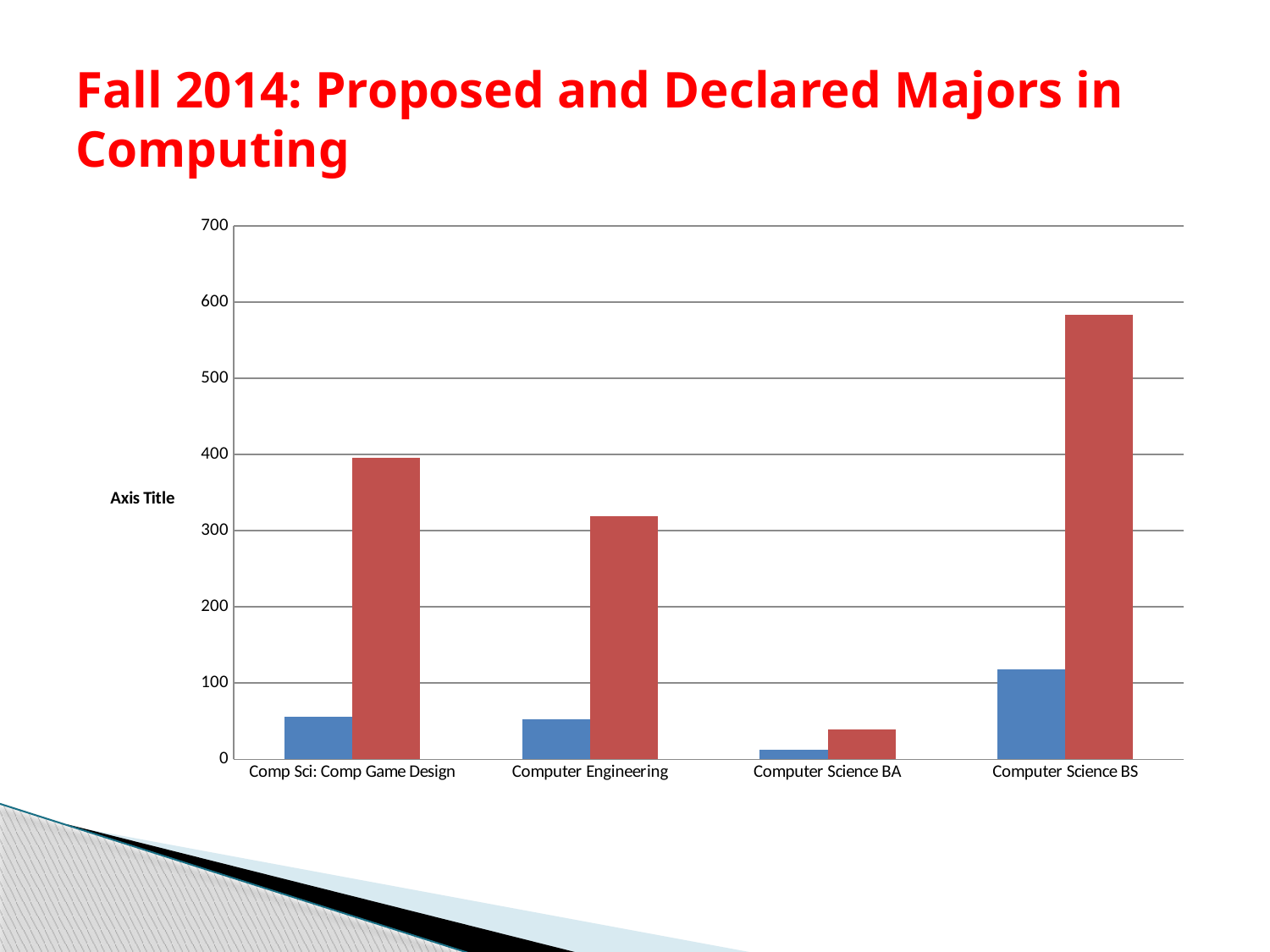
Which category has the shortest blue bar? Computer Science BA Which category has the shortest red bar? Computer Science BA Which category has the tallest red bar? Computer Science BS Which category has the tallest blue bar? Computer Science BS What kind of chart is shown on the slide? bar chart Is the blue bar for Computer Science BS greater or less than 100? greater Is the red bar for Comp Sci: Comp Game Design greater or less than 300? greater How many categories are shown along the x axis? 4 What is the title of the slide? Fall 2014: Proposed and Declared Majors in Computing Is the red bar for Computer Engineering greater or less than 400? less Which is larger, the red bar for Comp Sci: Comp Game Design or the red bar for Computer Engineering? Comp Sci: Comp Game Design